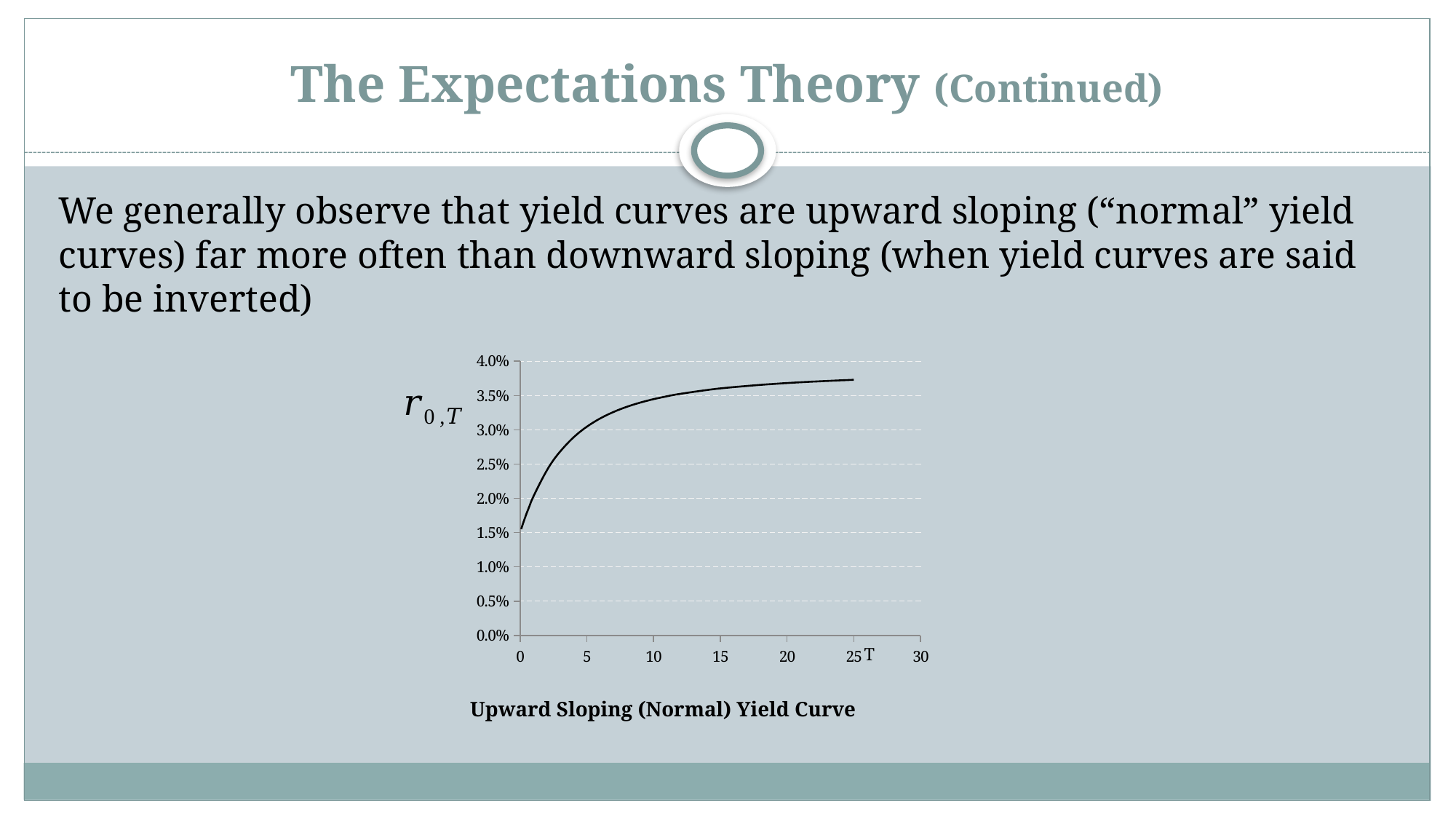
What is the caption printed below the chart? Upward Sloping (Normal) Yield Curve Is the value of the yield curve at T = 0 greater or less than 2.0%? less How many lines (series) are plotted on the chart? 1 Is the value of the yield curve at T = 10 greater or less than 3.0%? greater Does the yield curve rise or fall as T increases along the x axis? rises Is the value of the yield curve at T = 0 greater or less than 1.0%? greater What is the highest value shown on the chart's y axis? 4.0% What kind of chart is shown on the slide? line chart Which is larger, the yield at T = 5 or the yield at T = 20? T = 20